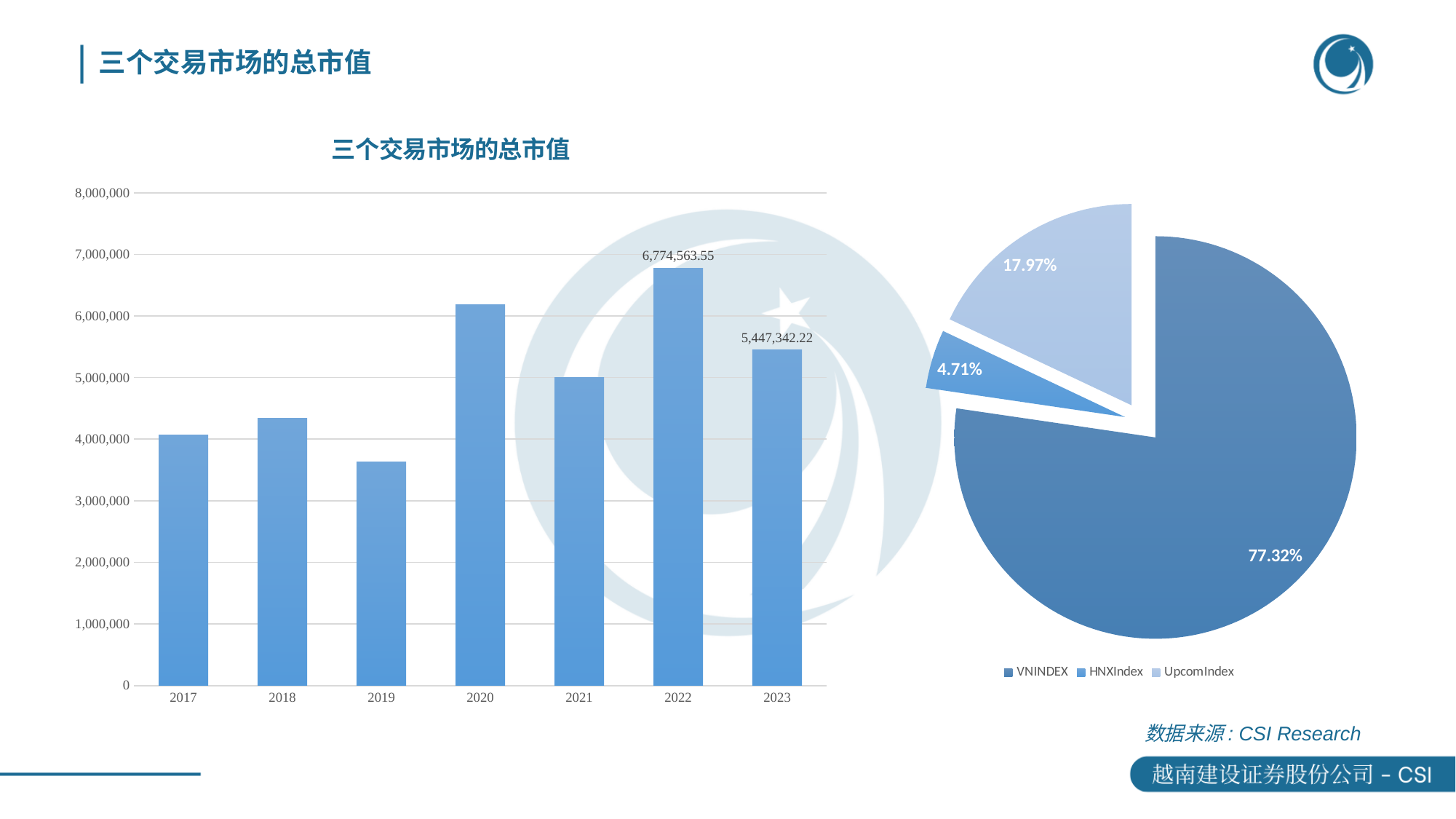
In the bar chart titled 三个交易市场的总市值, which is larger, the value for 2018 or the value for 2021? 2021 In the pie chart on the right, what share does VNINDEX have? 77.32% In the bar chart titled 三个交易市场的总市值, which year has the highest value? 2022 In the bar chart titled 三个交易市场的总市值, what is the value for 2022? 6,774,563.55 In the pie chart on the right, which slice is the smallest? HNXIndex How many entries does the legend of the pie chart on the right list? 3 In the bar chart titled 三个交易市场的总市值, which year has the lowest value? 2019 In the bar chart titled 三个交易市场的总市值, what is the difference between the 2022 and 2023 values? 1,327,221.33 How many years are shown on the x axis of the bar chart titled 三个交易市场的总市值? 7 In the bar chart titled 三个交易市场的总市值, is the value for 2020 greater or less than 6,000,000? greater In the bar chart titled 三个交易市场的总市值, what is the value for 2023? 5,447,342.22 In the bar chart titled 三个交易市场的总市值, is the value for 2019 greater or less than 4,000,000? less